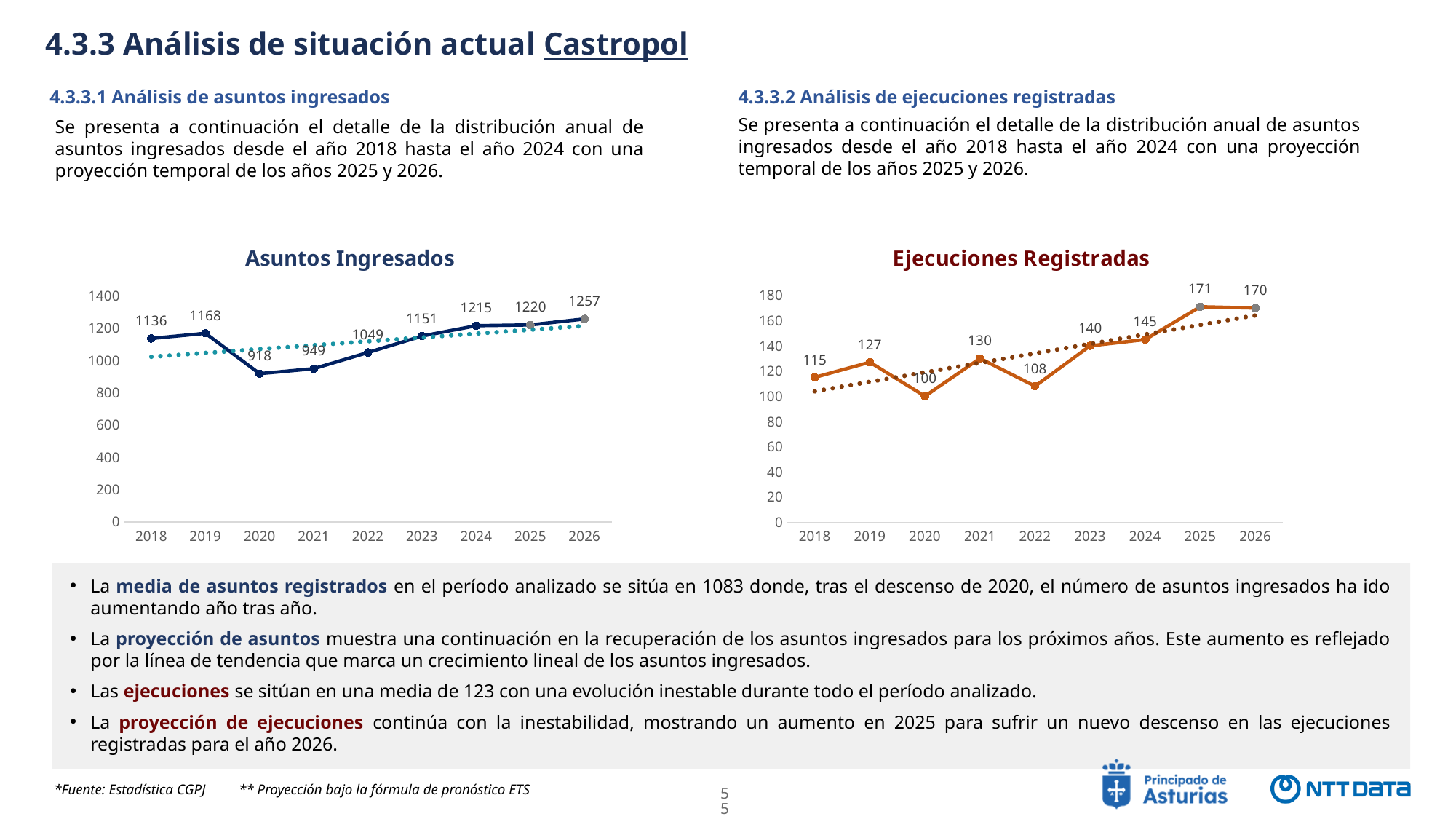
In the 'Ejecuciones Registradas' chart, what is the difference between the values for 2025 and 2024? 26 In the 'Asuntos Ingresados' chart, how many years are plotted on the x axis? 9 In the 'Asuntos Ingresados' chart, do the values rise or fall from 2020 to 2026? Rise In the 'Ejecuciones Registradas' chart, which year has the highest value? 2025 In the 'Ejecuciones Registradas' chart, what is the value for 2022? 108 What kind of chart is 'Asuntos Ingresados'? Line chart In the 'Asuntos Ingresados' chart, what is the difference between the values for 2019 and 2020? 250 In the 'Asuntos Ingresados' chart, what is the value for 2020? 918 In the 'Ejecuciones Registradas' chart, which year has the lowest value? 2020 In the 'Ejecuciones Registradas' chart, which is larger, the value for 2021 or the value for 2022? 2021 In the 'Asuntos Ingresados' chart, what is the value for 2026? 1257 In the 'Asuntos Ingresados' chart, which year has the lowest value? 2020